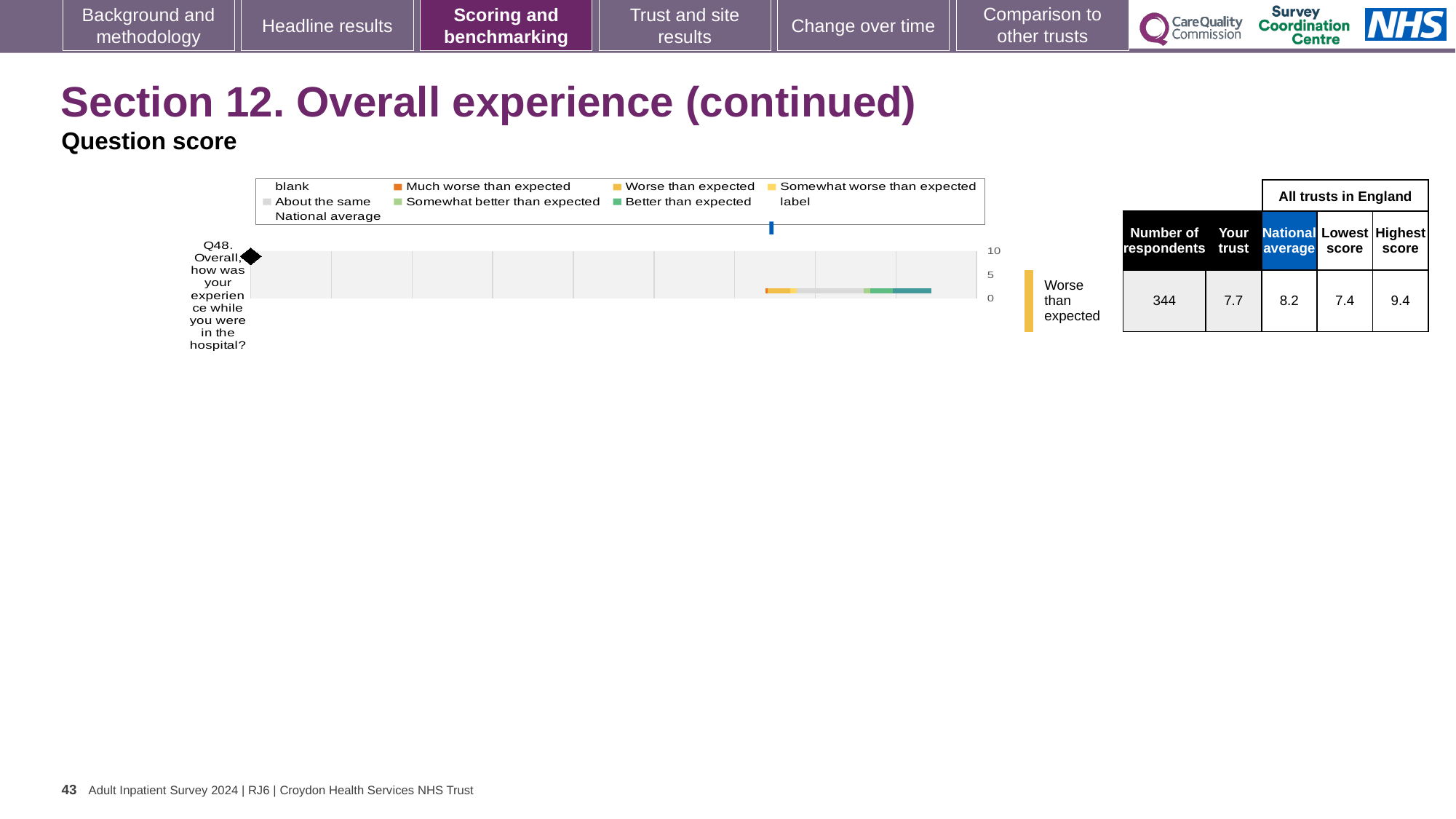
What is the 'Your trust' score for Q48? 7.7 How many questions (categories) are plotted on the chart? 1 What is the highest score among all trusts in England for Q48? 9.4 What is the difference between the highest and lowest scores among all trusts in England for Q48? 2.0 What benchmarking category label is shown next to the chart for Q48? Worse than expected Which is larger for Q48, the 'Your trust' score or the national average? National average What is the difference between the national average and the 'Your trust' score for Q48? 0.5 How many respondents answered Q48? 344 What is the highest value shown on the chart's axis? 10 What kind of chart is used to show the Q48 question score? bar chart What is the national average score for Q48? 8.2 What is the lowest score among all trusts in England for Q48? 7.4